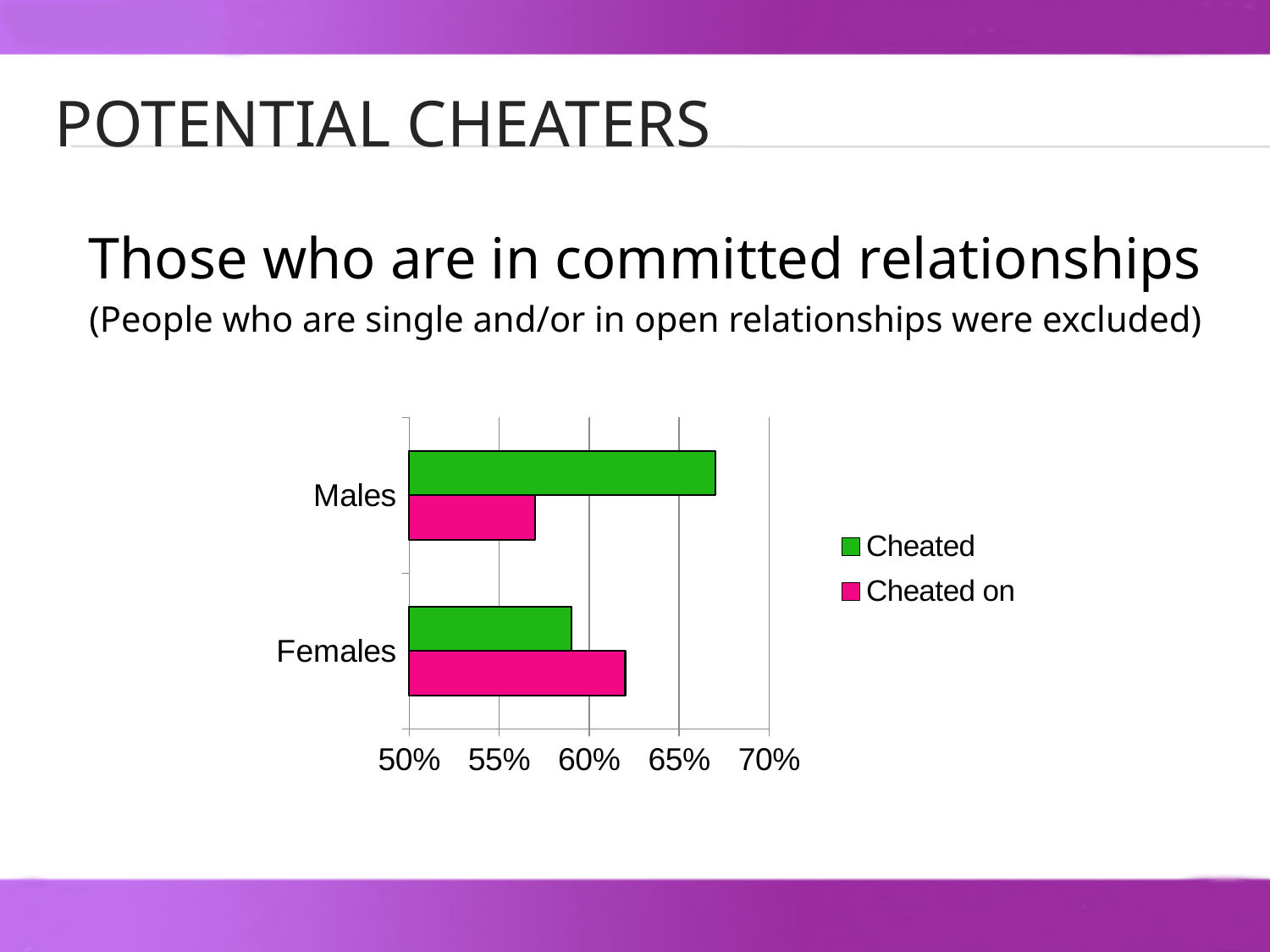
Is the Cheated on value for Males greater or less than 60%? less Which series is shown in pink in the chart? Cheated on For Females, which is larger: the Cheated value or the Cheated on value? Cheated on Is the Cheated value for Males greater or less than 65%? greater Which series is shown in green in the chart? Cheated Is the Cheated on value for Females greater or less than 60%? greater How many series does the chart legend list? 2 What kind of chart is shown on the slide? bar chart Which category has the highest Cheated value? Males For Males, which is larger: the Cheated value or the Cheated on value? Cheated How many categories are shown on the chart's vertical axis? 2